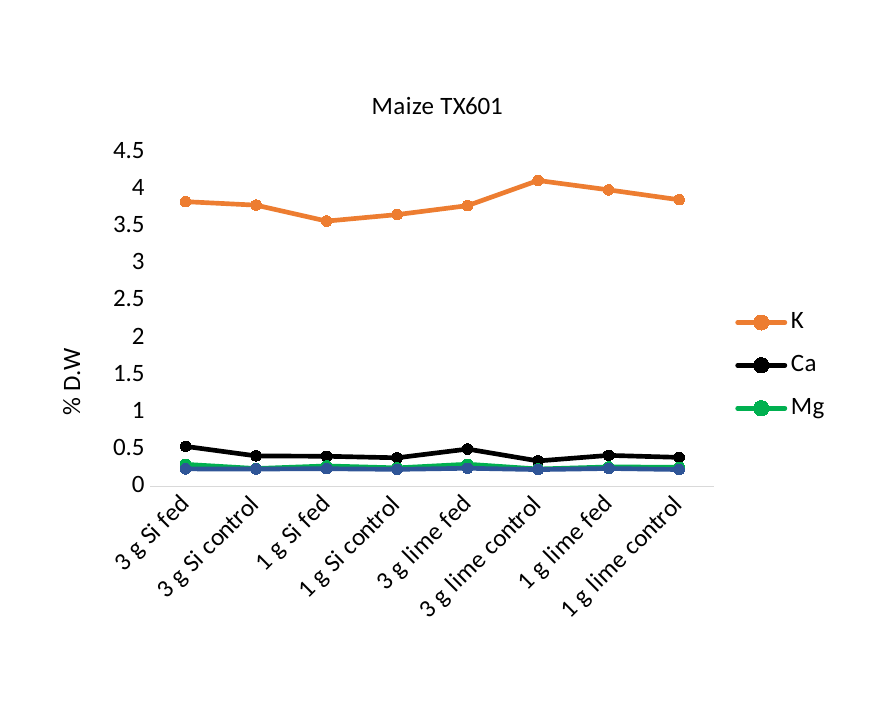
What is the title of the chart? Maize TX601 How many categories are shown on the x axis? 8 How many series does the legend list? 3 Is the value of K for 3 g lime control greater or less than 4? greater For which category is the K series highest? 3 g lime control Which series has the larger value for 1 g lime fed, K or Ca? K Is the value of Ca for 3 g lime control greater or less than 0.5? less Is the value of K for 3 g Si fed greater or less than 4? less Which series has the larger value for 3 g Si fed, Ca or Mg? Ca What kind of chart is shown on the slide? line chart What is the label of the y axis? % D.W